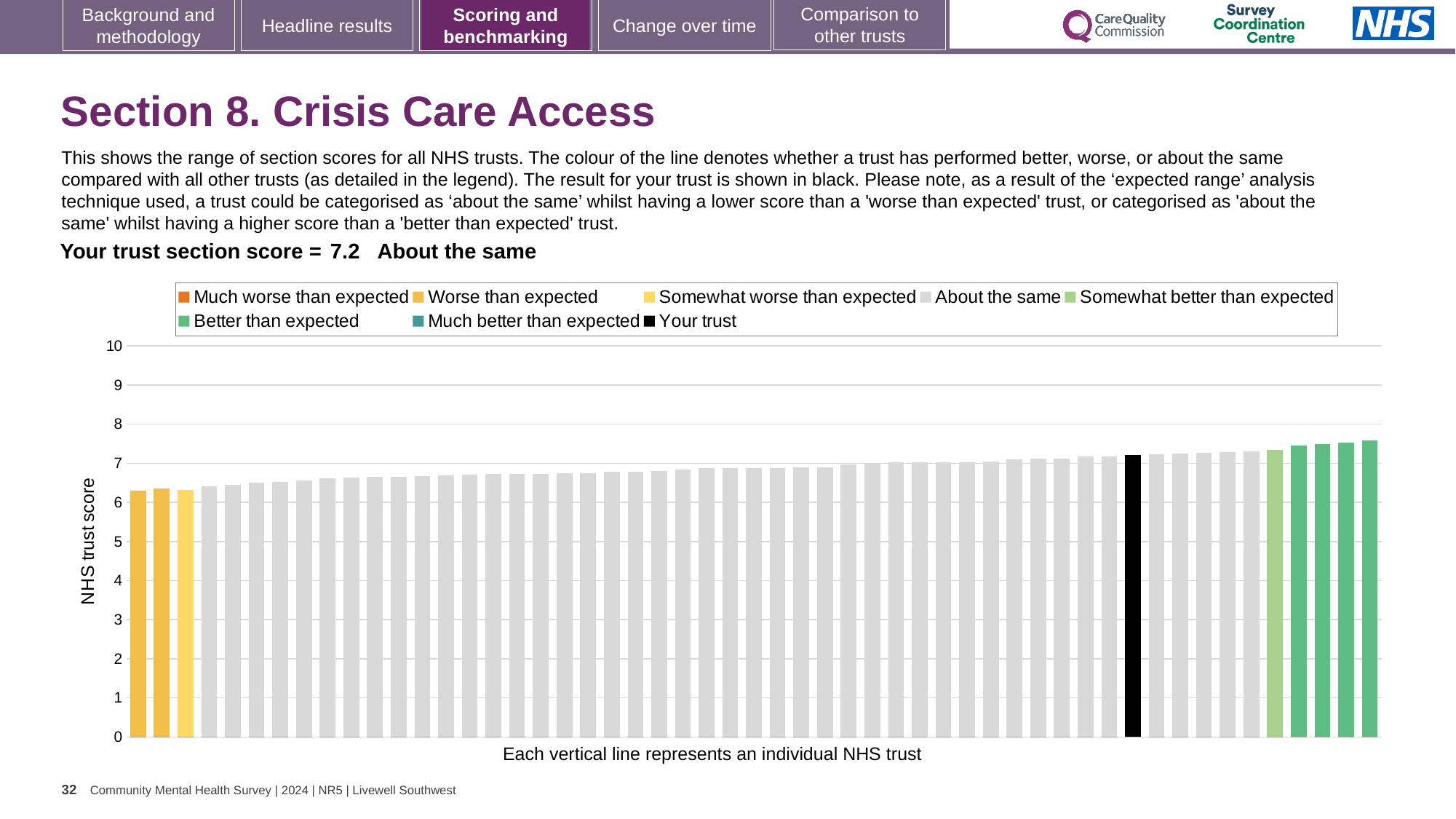
What kind of chart is shown on the slide? bar chart What colour is the bar representing your trust? black What is the label on the y axis of the chart? NHS trust score Which performance category is your trust placed in for Crisis Care Access? About the same Is the value of the lowest bar on the chart greater or less than 6? greater Do the bar values rise or fall moving from left to right along the x axis? rise Is the value for your trust (the black bar) greater or less than 7? greater What is the section score for your trust shown on the slide? 7.2 Is the value for your trust (the black bar) greater or less than 8? less How many series does the chart legend list? 8 How many bars are coloured as 'Worse than expected'? 2